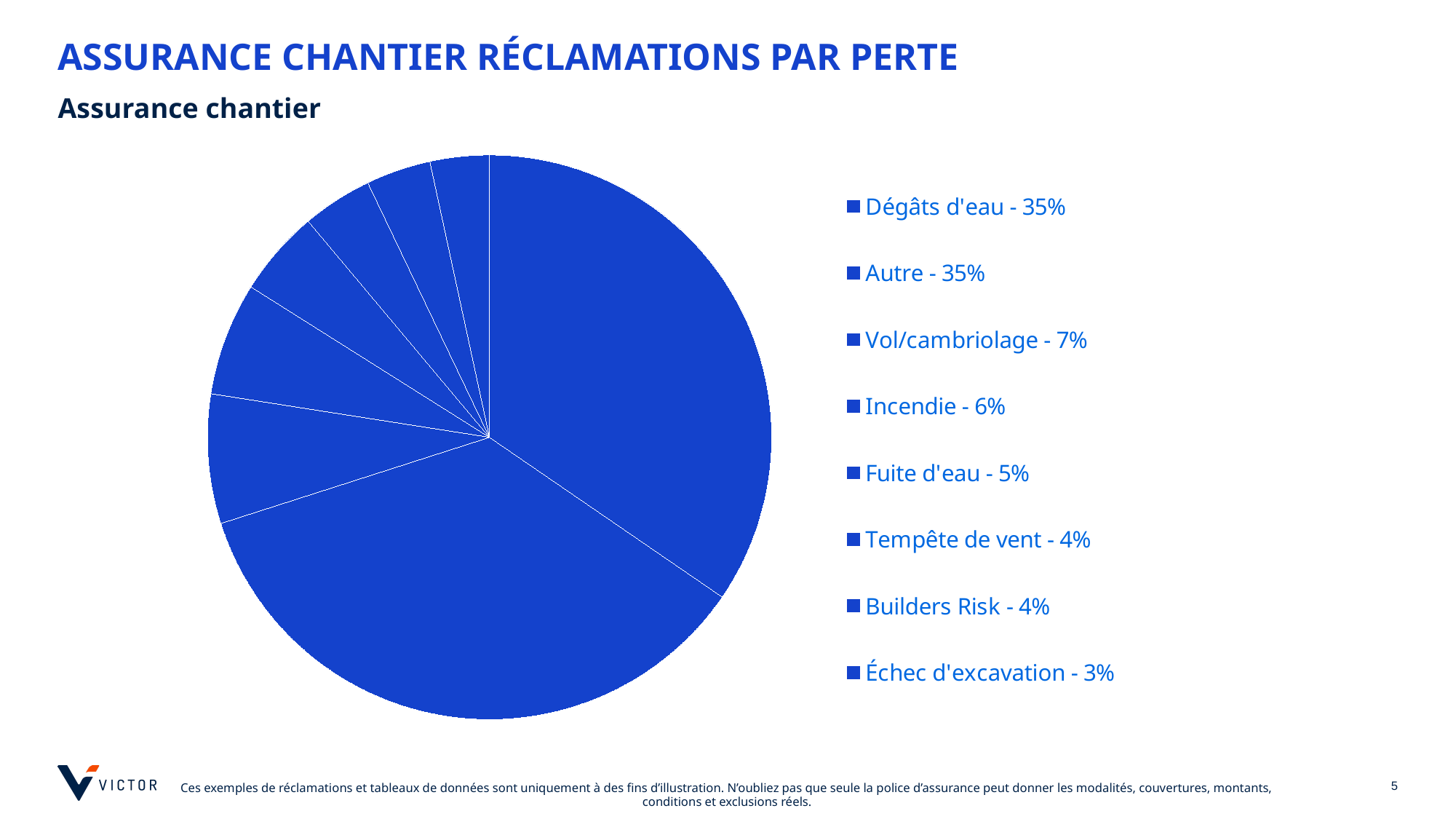
Which two categories share the largest percentage of claims? Dégâts d'eau and Autre What is the difference in percentage points between Dégâts d'eau and Vol/cambriolage? 28 What share of the pie does Échec d'excavation represent? 3% What share of claims is attributed to Vol/cambriolage? 7% What percentage is shown for Incendie? 6% Which category has the smallest share of claims? Échec d'excavation Which is larger, the share for Vol/cambriolage or the share for Incendie? Vol/cambriolage How many categories does the pie chart have? 8 What is the subtitle shown above the pie chart? Assurance chantier What percentage is shown for Fuite d'eau? 5% What kind of chart is shown on the slide? pie chart What percentage is shown for Tempête de vent? 4%